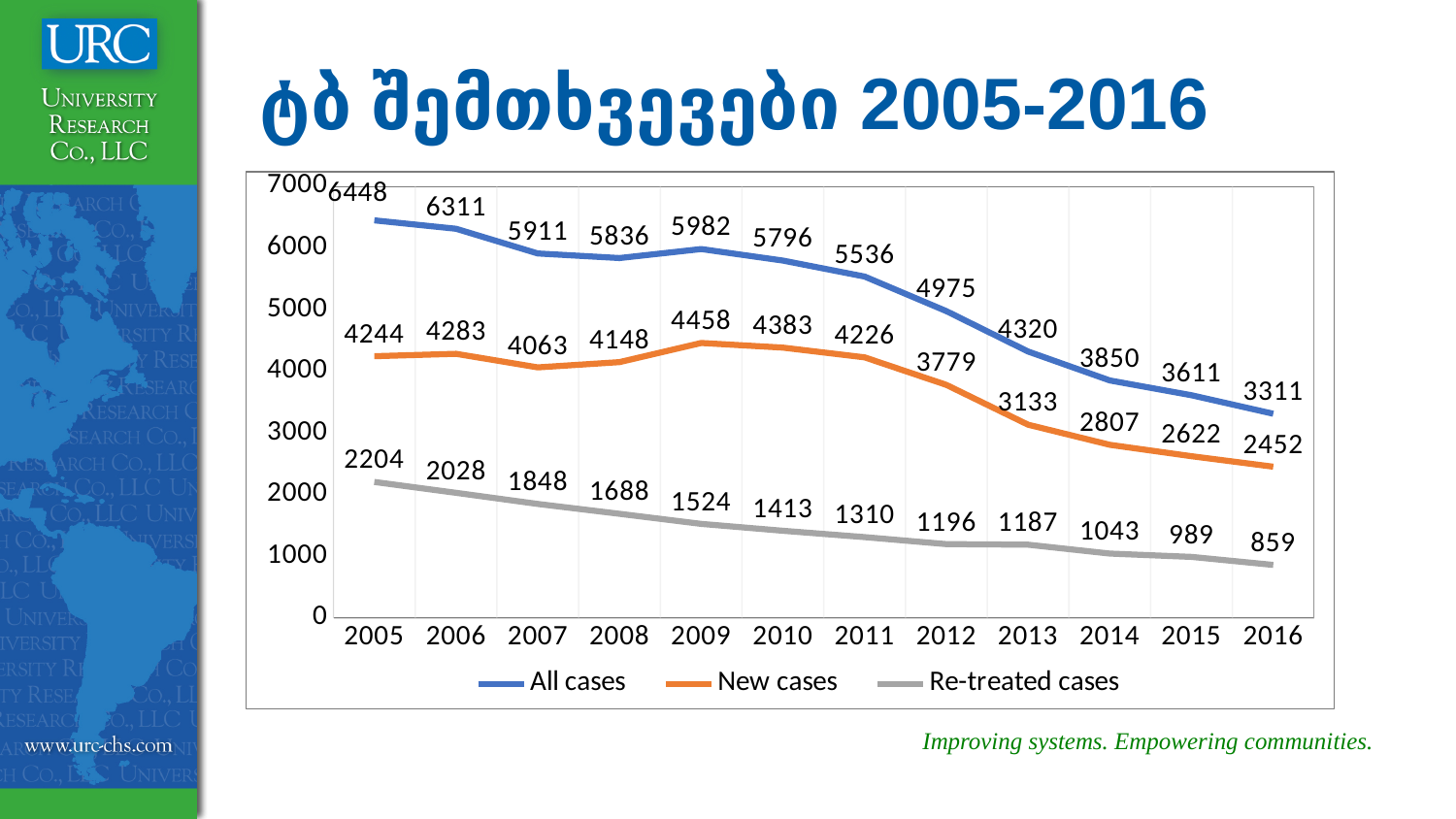
What is the difference between All cases and New cases in 2005? 2204 In which year is the Re-treated cases series lowest? 2016 What is the value for All cases in 2009? 5982 What is the value for New cases in 2013? 3133 In which year is the All cases series highest? 2005 Which is larger: New cases in 2009 or New cases in 2011? New cases in 2009 How many years are plotted along the x axis? 12 Which series is shown in orange in the legend? New cases Does the Re-treated cases series generally rise or fall from 2005 to 2016? Fall How many series does the legend list? 3 What is the value for Re-treated cases in 2016? 859 What type of chart is shown on the slide? Line chart